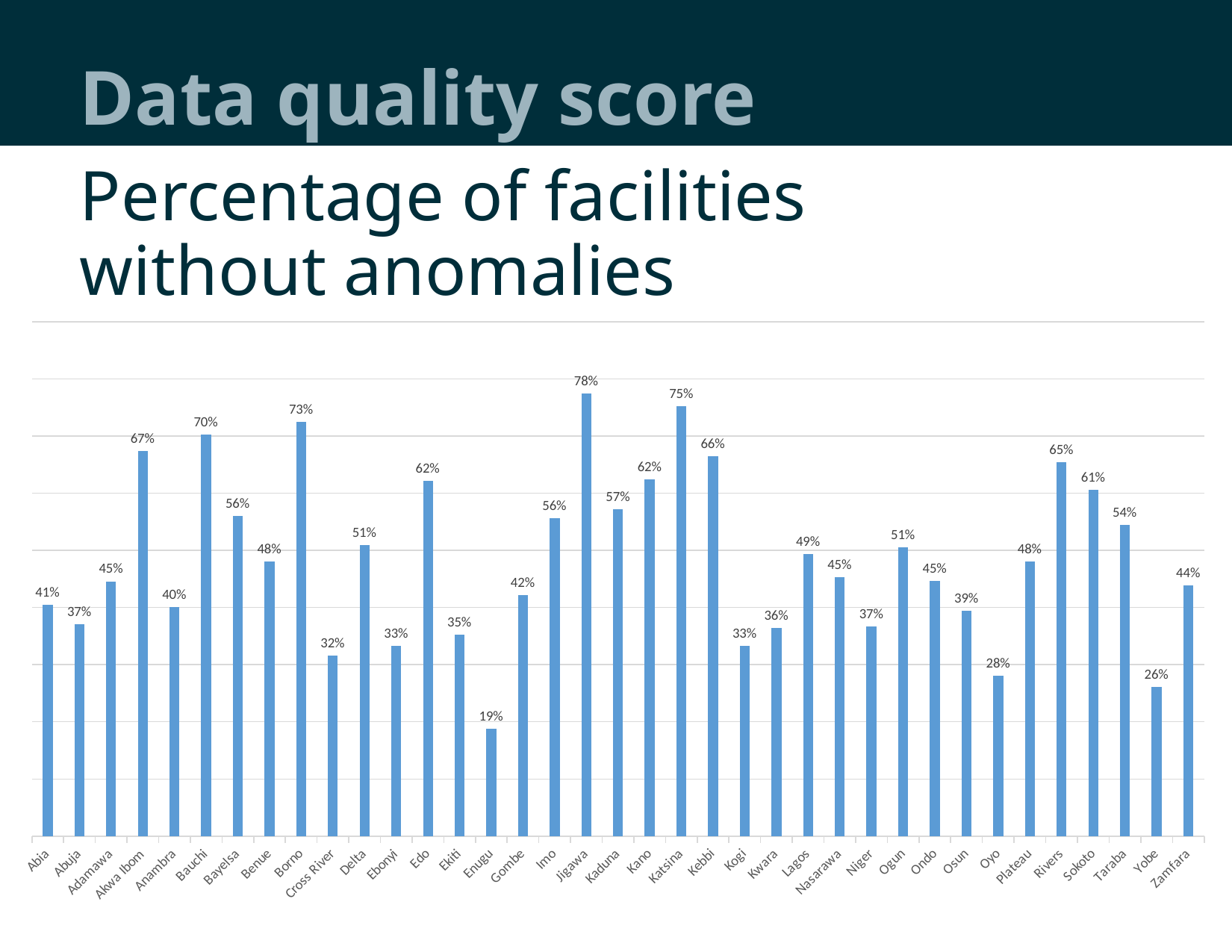
What is the difference between the values for Bauchi and Oyo? 42% What is the value for Jigawa? 78% What is the value for Yobe? 26% What is the subtitle describing the chart? Percentage of facilities without anomalies Which state has the lowest percentage of facilities without anomalies? Enugu Which state has the highest percentage of facilities without anomalies? Jigawa What kind of chart is shown on the slide? Bar chart What is the difference between the values for Katsina and Kebbi? 9% What is the value for Borno? 73% What is the value for Enugu? 19% How many states are shown on the chart? 37 Which is larger, the value for Rivers or the value for Sokoto? Rivers